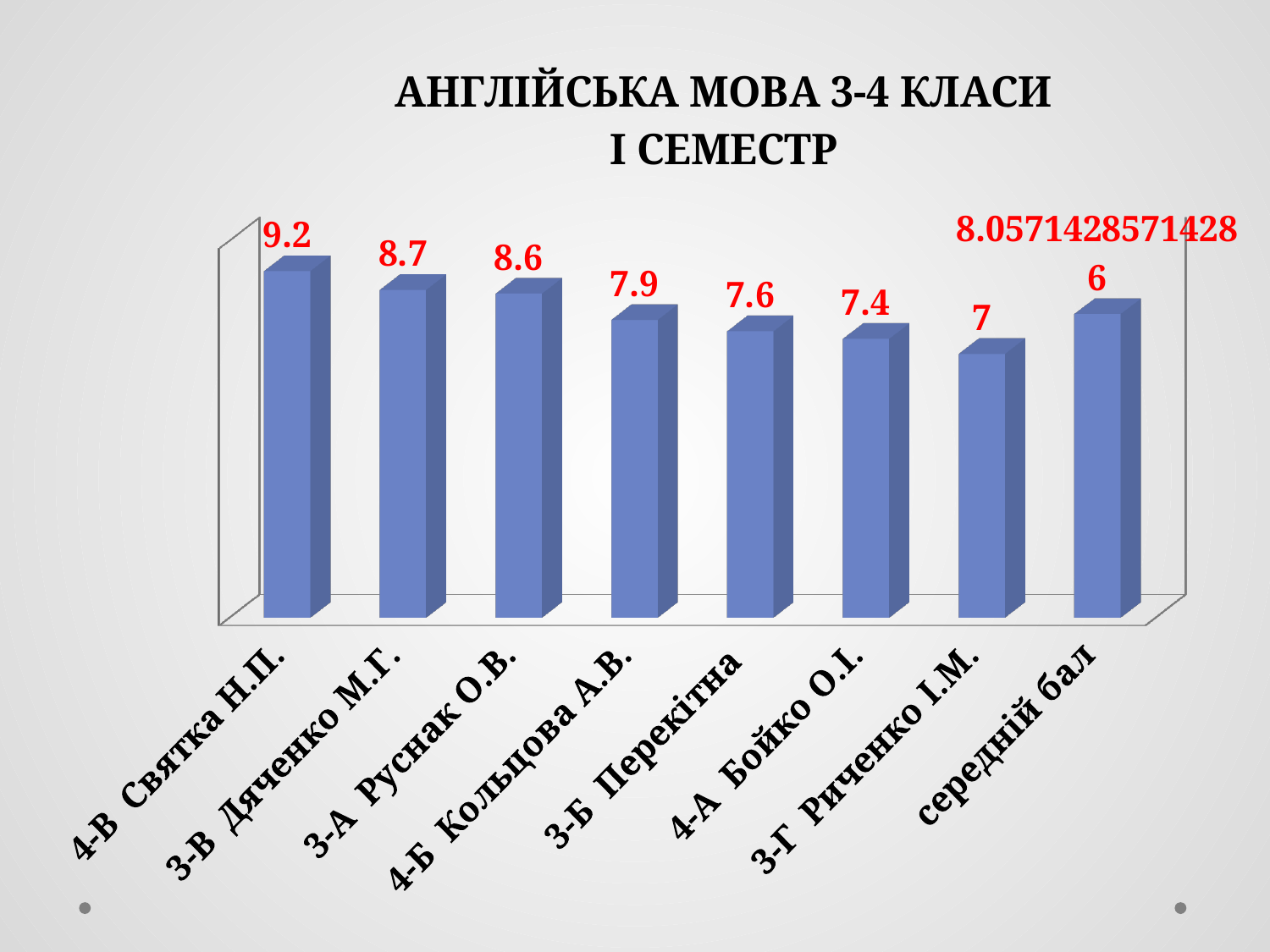
What is the value for 4-Б Кольцова А.В.? 7.9 What is the value for 3-Г Риченко І.М.? 7 What kind of chart is shown on the slide? Bar chart What is the value for 3-В Дяченко М.Г.? 8.7 Which category has the highest value? 4-В Святка Н.П. What is the title of the chart? АНГЛІЙСЬКА МОВА 3-4 КЛАСИ І СЕМЕСТР Which is larger, the value for 3-А Руснак О.В. or the value for 3-Б Перекітна? 3-А Руснак О.В. How many categories are shown on the x axis? 8 What is the difference between the values for 4-В Святка Н.П. and 3-Г Риченко І.М.? 2.2 What is the value for 4-В Святка Н.П.? 9.2 Which category has the lowest bar? 3-Г Риченко І.М. What is the value for 4-А Бойко О.І.? 7.4